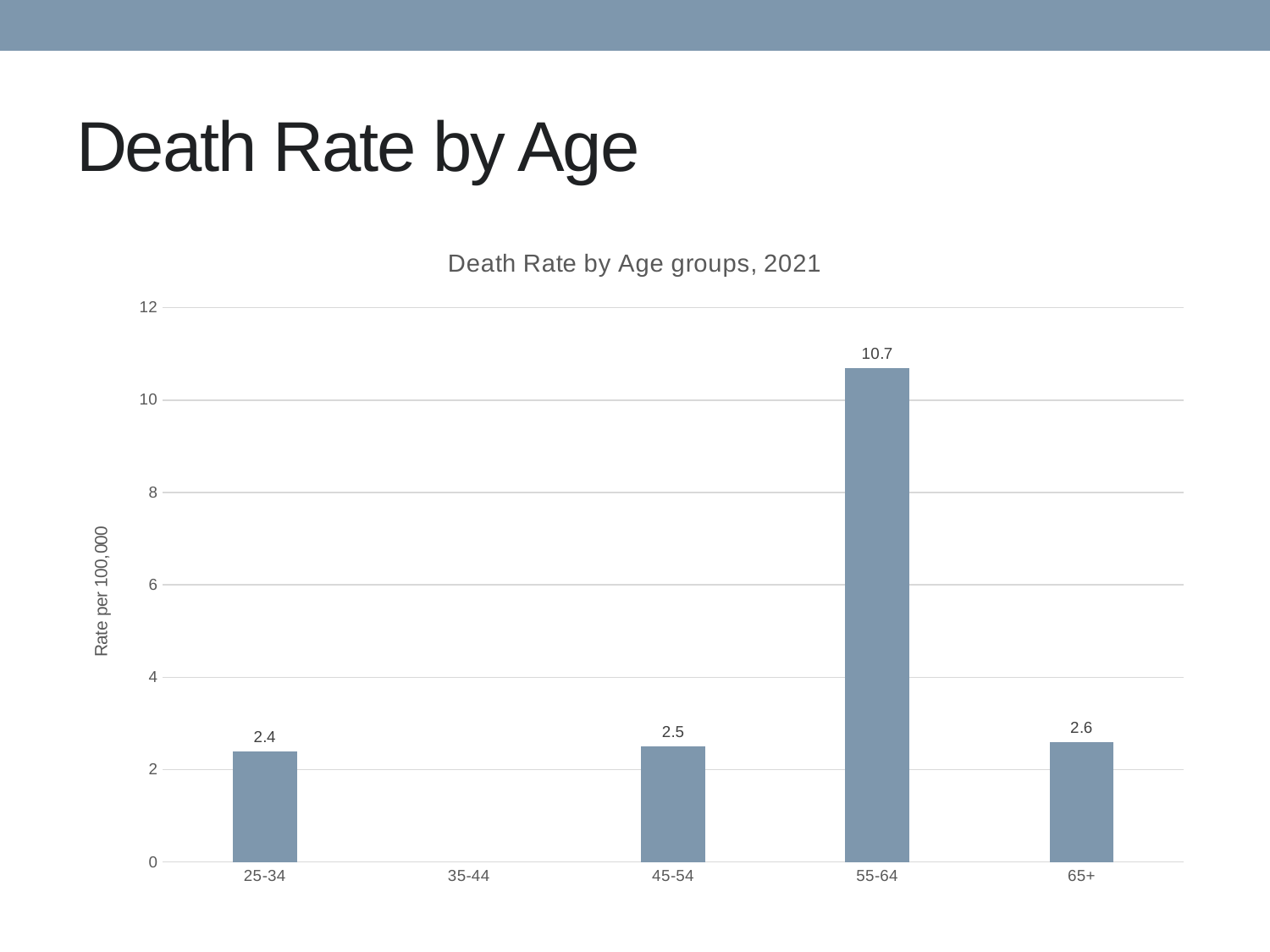
Which has a larger death rate, the 55-64 group or the 65+ group? 55-64 Which age group has the highest death rate? 55-64 What is the label of the vertical axis? Rate per 100,000 What is the death rate for the 45-54 age group? 2.5 What is the death rate for the 55-64 age group? 10.7 How many age groups are shown on the x axis? 5 What kind of chart is shown on the slide? Bar chart What is the difference between the death rate for 65+ and the death rate for 25-34? 0.2 What is the death rate for the 65+ age group? 2.6 Is the death rate for the 55-64 age group greater or less than 10? greater What is the death rate for the 25-34 age group? 2.4 What is the difference between the death rate for 55-64 and the death rate for 65+? 8.1